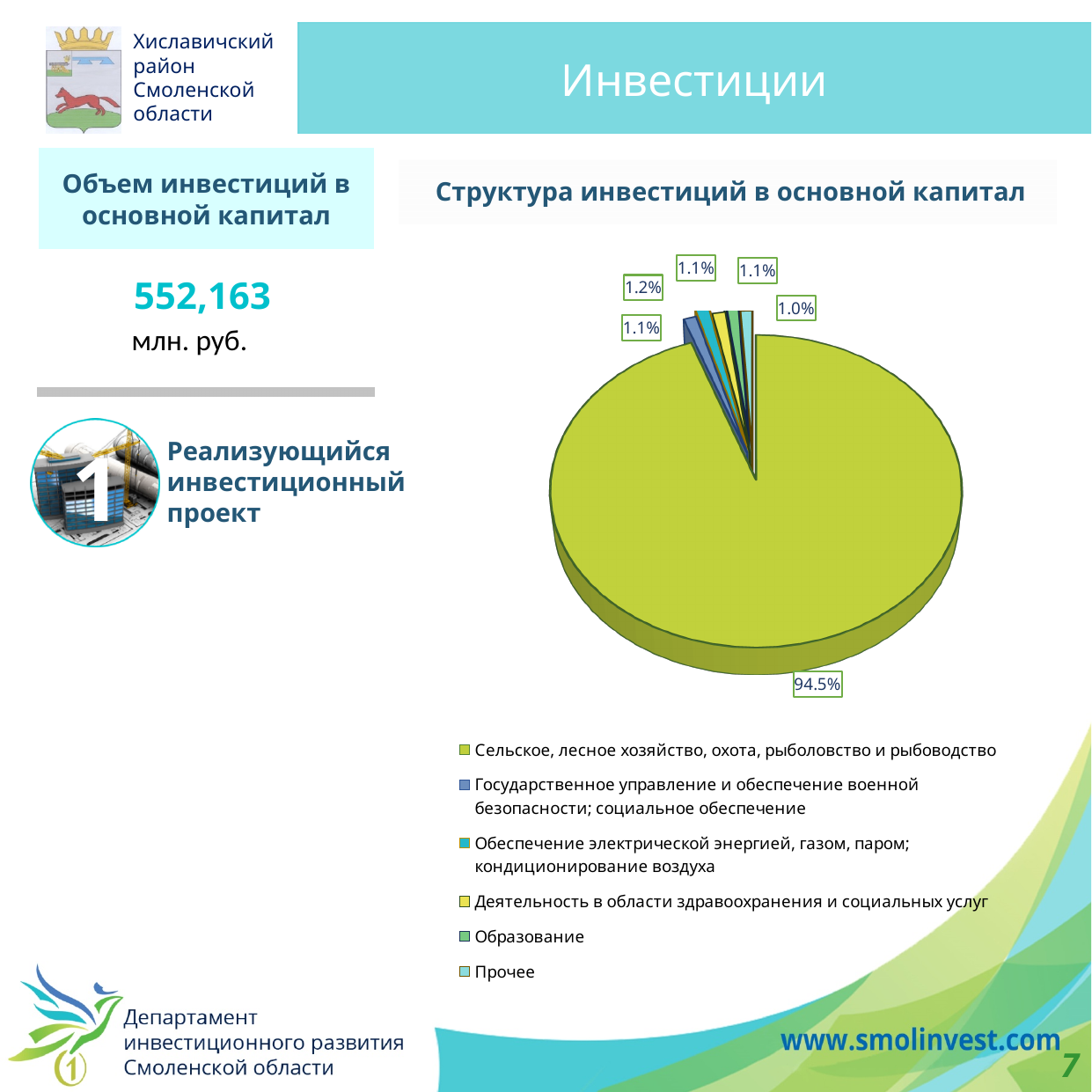
What share of the pie does 'Сельское, лесное хозяйство, охота, рыболовство и рыбоводство' have? 94.5% What is the title of the pie chart? Структура инвестиций в основной капитал What is the smallest percentage label shown on the pie chart? 1.0% What is the largest percentage label shown on the pie chart? 94.5% What colour is the slice for 'Сельское, лесное хозяйство, охота, рыболовство и рыбоводство'? green What share of the pie does 'Прочее' have? 1.0% How many percentage labels on the pie chart show a value below 2%? 5 Is the share for 'Сельское, лесное хозяйство, охота, рыболовство и рыбоводство' greater or less than 90%? greater Which is larger: the slice for 'Сельское, лесное хозяйство, охота, рыболовство и рыбоводство' or the slice for 'Образование'? Сельское, лесное хозяйство, охота, рыболовство и рыбоводство Which category has the largest slice of the pie? Сельское, лесное хозяйство, охота, рыболовство и рыбоводство How many categories does the pie chart's legend list? 6 What kind of chart is shown under the title 'Структура инвестиций в основной капитал'? pie chart